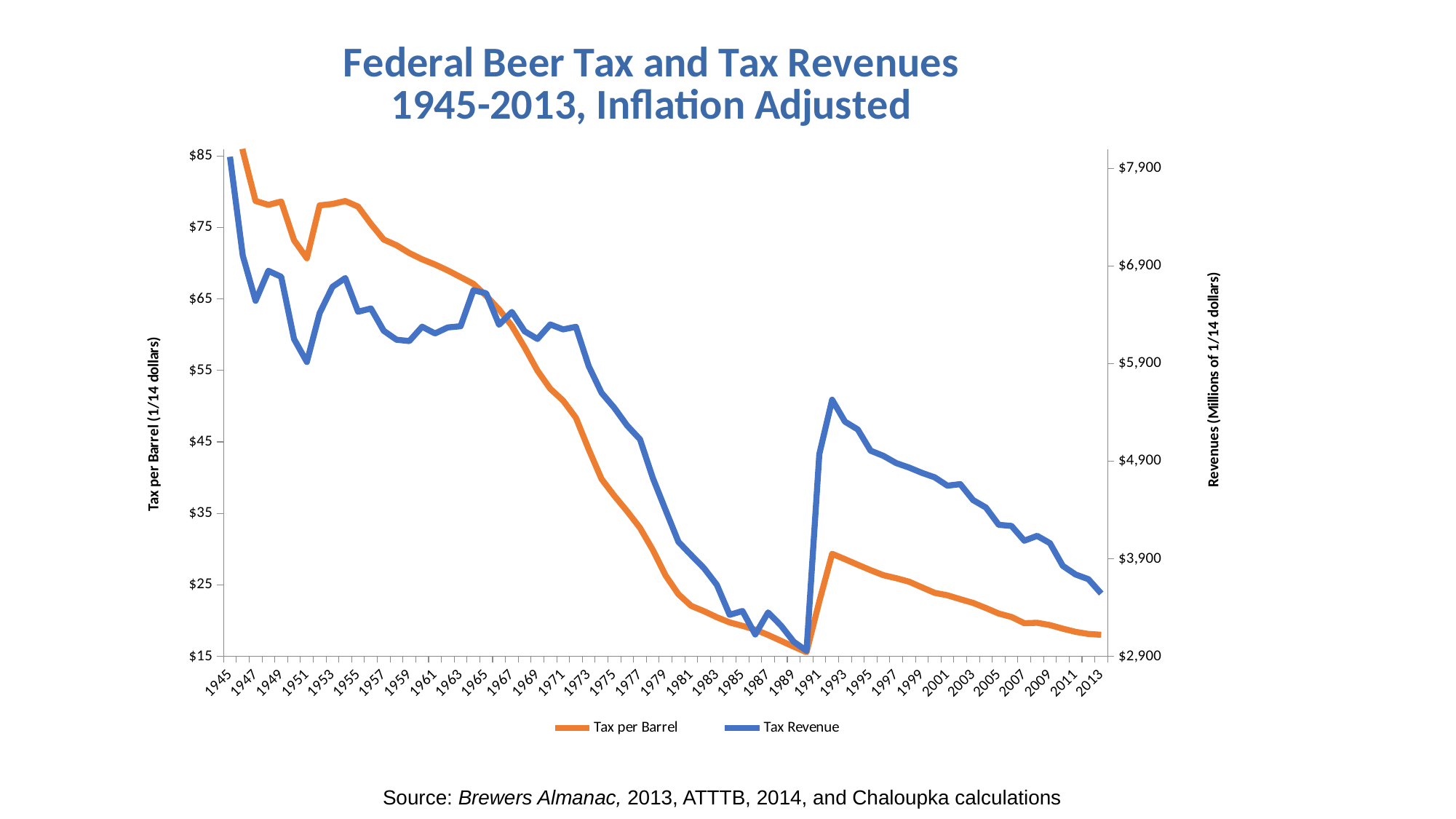
Does the Tax Revenue line generally rise or fall from 1993 to 2013? fall Is the Tax per Barrel value for 1981 greater or less than $35? less Is the Tax per Barrel value for 1945 greater or less than $75? greater What is the title of the chart? Federal Beer Tax and Tax Revenues 1945-2013, Inflation Adjusted Is the Tax per Barrel value for 2013 greater or less than $25? less Does the Tax per Barrel line generally rise or fall from 1945 to 1989? fall Does the Tax per Barrel line rise or fall between 1990 and 1992? rise What kind of chart is shown on the slide? Line chart What are the two series named in the legend? Tax per Barrel and Tax Revenue How many series does the legend list? 2